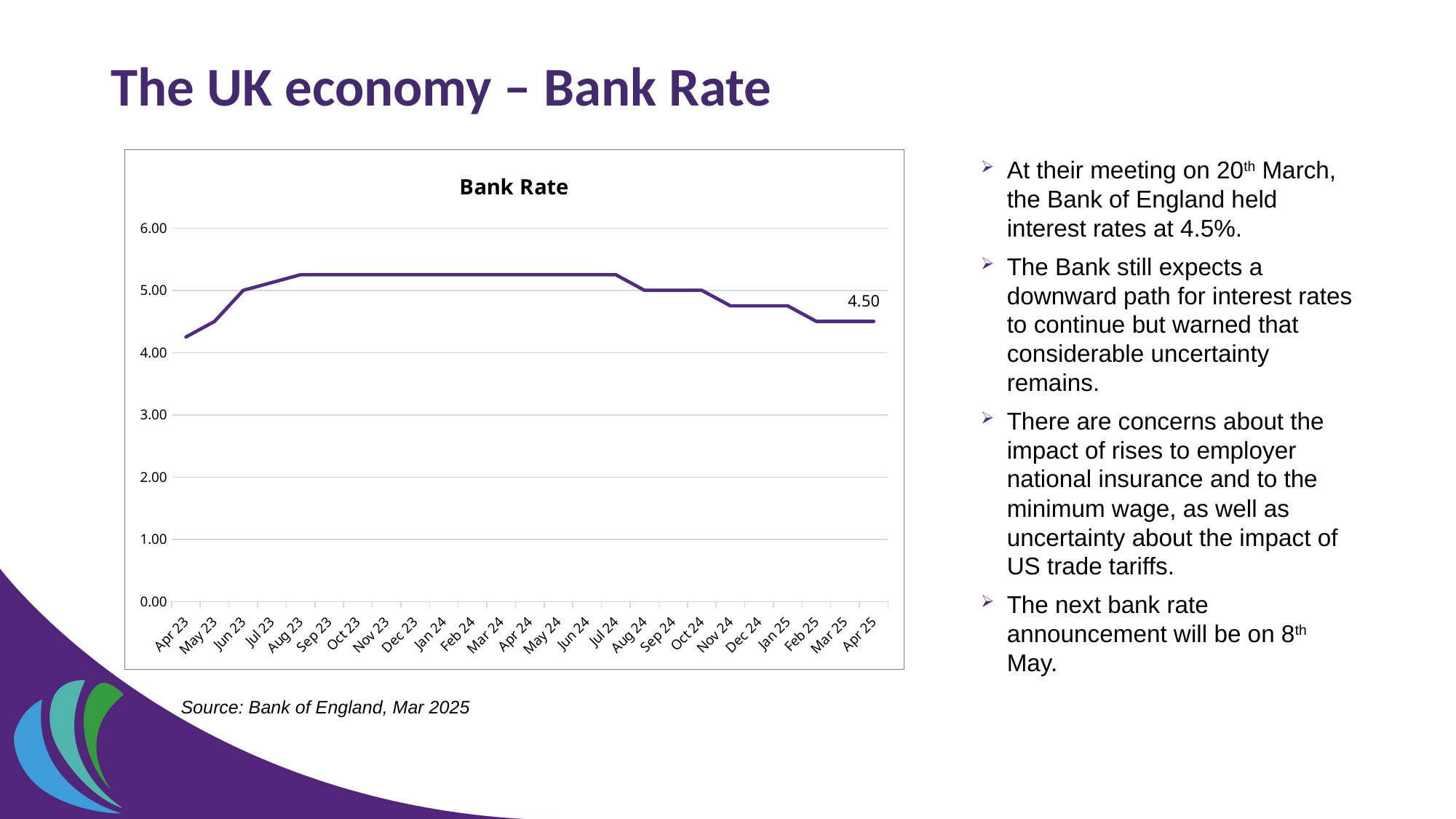
Is the Bank Rate for Nov 24 greater or less than 4.00? greater What kind of chart is used to show the Bank Rate? line chart Does the Bank Rate rise or fall between Apr 23 and Aug 23? rise Which month has the lowest Bank Rate on the chart? Apr 23 Which is larger, the Bank Rate in Apr 23 or in Jan 24? Jan 24 Is the Bank Rate for Jan 24 greater or less than 5.00? greater Is the Bank Rate for Apr 23 greater or less than 5.00? less What is the title of the chart? Bank Rate What is the highest value shown on the chart's vertical axis? 6.00 What is the value of the Bank Rate shown for Apr 25? 4.50 Does the Bank Rate rise or fall between Jul 24 and Apr 25? fall